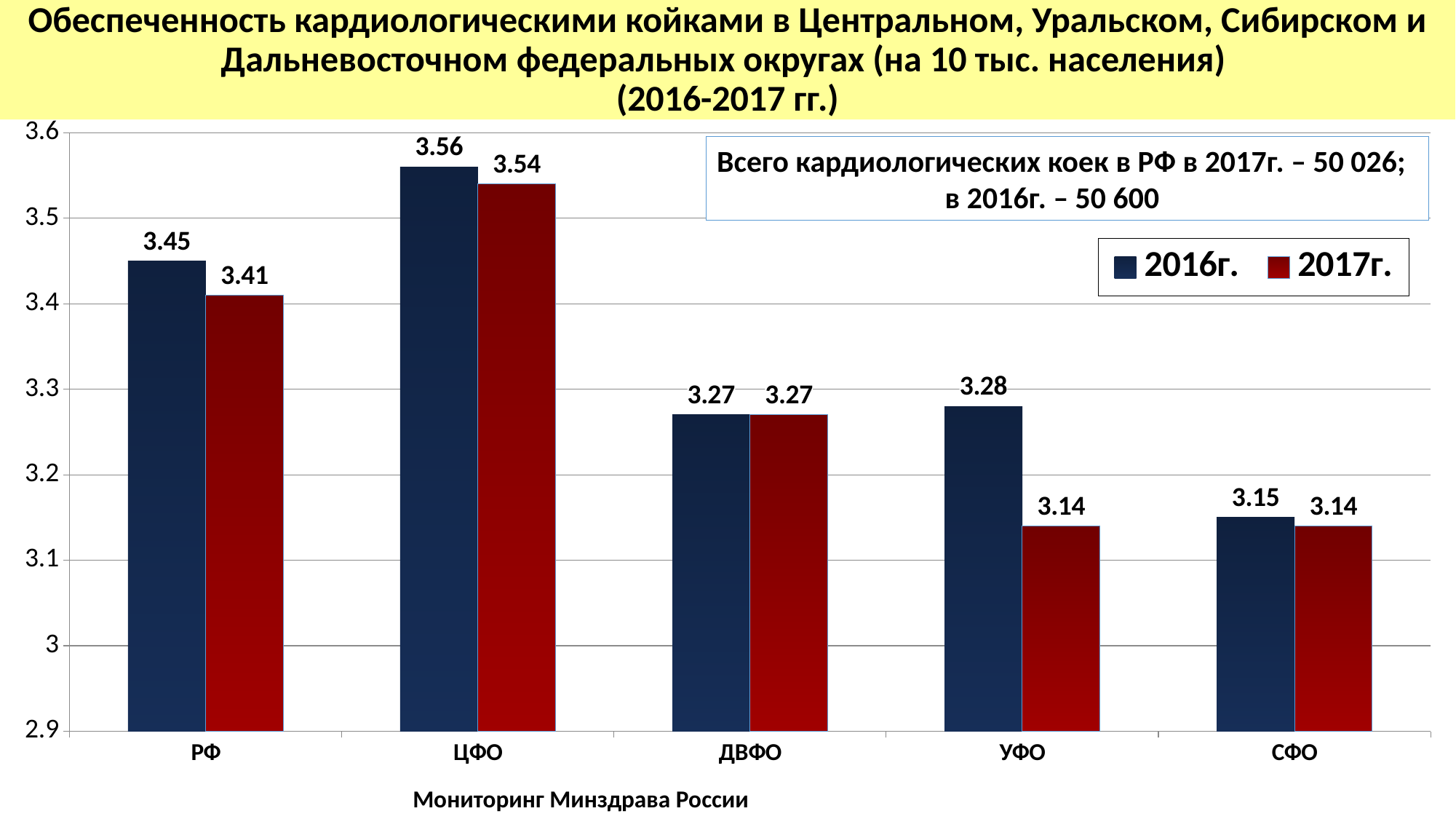
Is the 2016г. value for СФО greater or less than 3.2? less Which category has the lowest value in 2017г.? УФО and СФО (both 3.14) Which category has the highest value in 2016г.? ЦФО What is the difference between the 2016г. and 2017г. values for УФО? 0.14 How many series does the legend list? 2 What is the value for РФ in 2017г.? 3.41 How many categories are shown on the x axis? 5 What is the value for УФО in 2017г.? 3.14 Which is larger for РФ: the 2016г. value or the 2017г. value? 2016г. What kind of chart is shown on the slide? bar chart What is the value for ЦФО in 2016г.? 3.56 According to the text box on the slide, how many cardiology beds were there in the РФ in 2017г.? 50 026